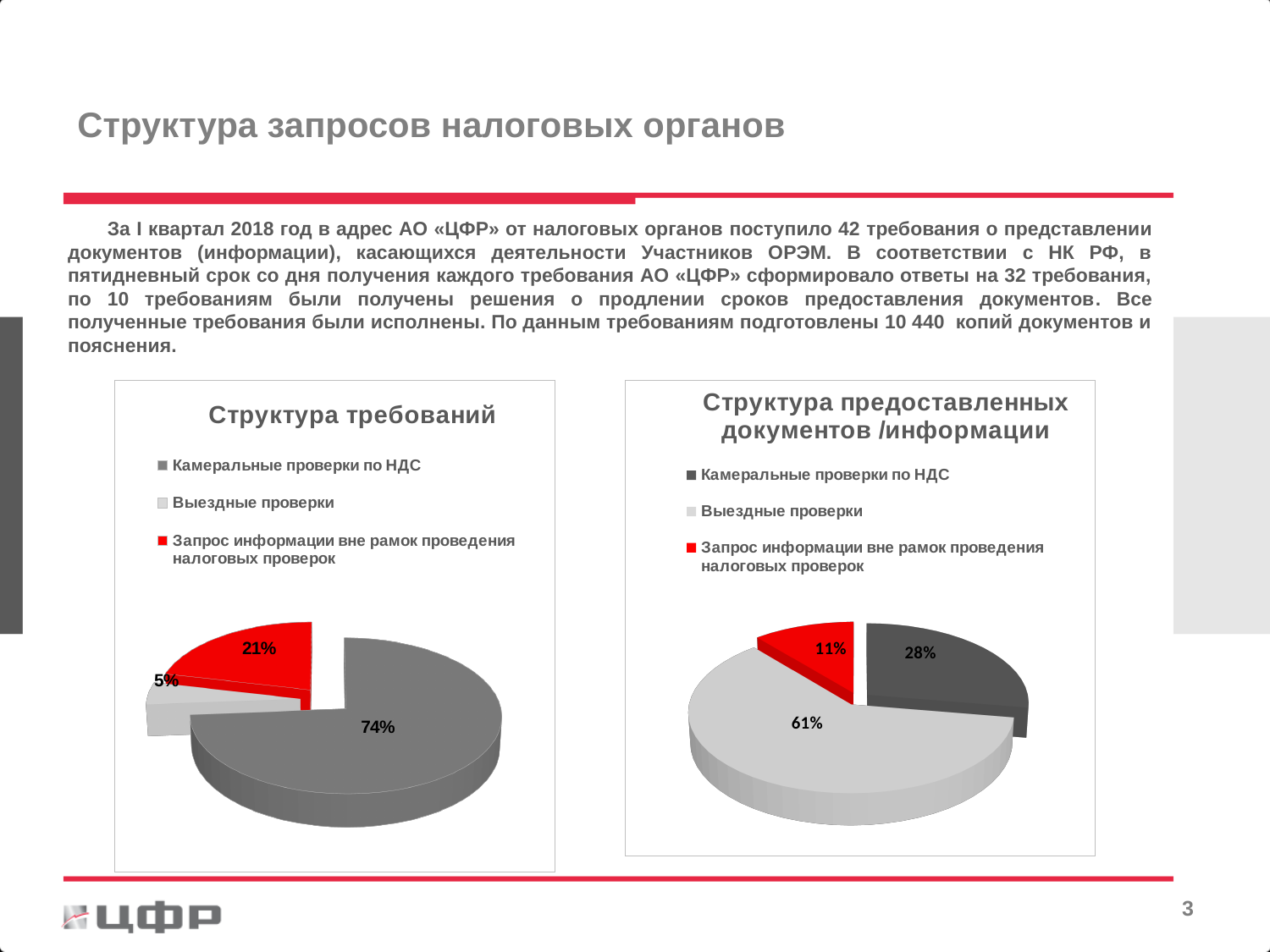
In the chart titled "Структура предоставленных документов /информации", which category has the largest slice? Выездные проверки In the chart titled "Структура требований", what share does "Выездные проверки" have? 5% In the chart titled "Структура предоставленных документов /информации", what is the difference between the shares of "Выездные проверки" and "Камеральные проверки по НДС"? 33% In the chart titled "Структура требований", which category has the largest slice? Камеральные проверки по НДС How many categories does the legend of the chart titled "Структура предоставленных документов /информации" list? 3 In the chart titled "Структура требований", what share does "Камеральные проверки по НДС" have? 74% What type of chart is the chart titled "Структура требований"? Pie chart In the chart titled "Структура предоставленных документов /информации", what share does "Камеральные проверки по НДС" have? 28% In the chart titled "Структура требований", which category has the smallest slice? Выездные проверки